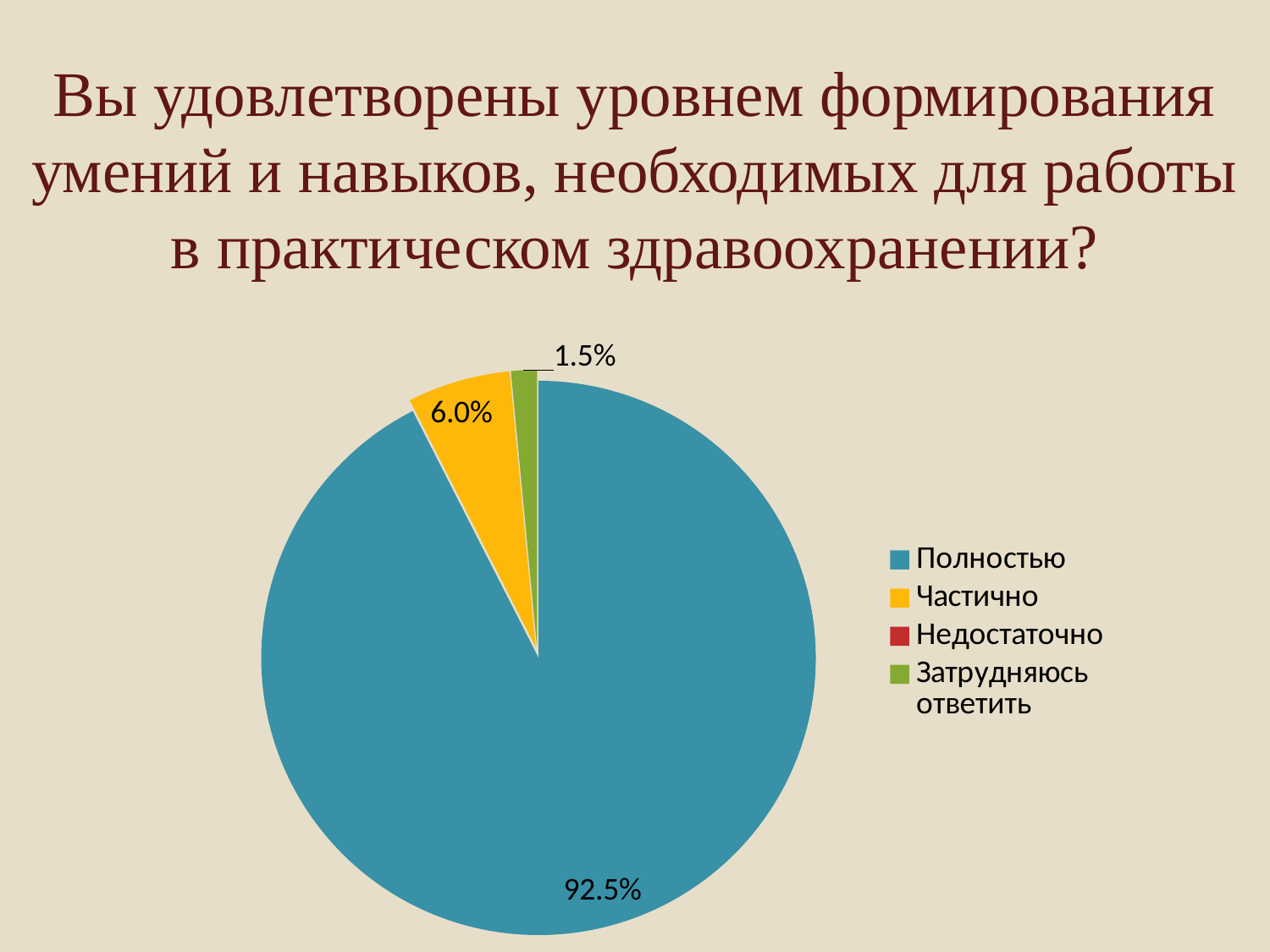
What percentage of respondents answered "Частично"? 6.0% Which answer category has the largest share of the pie? Полностью Which of the labelled slices is the smallest? Затрудняюсь ответить What percentage of respondents answered "Полностью"? 92.5% What type of chart is shown on the slide? pie chart What percentage of respondents answered "Затрудняюсь ответить"? 1.5% What is the difference in percentage points between "Полностью" and "Частично"? 86.5 How many categories are listed in the legend? 4 Which legend entry is shown in red? Недостаточно What colour is the slice for "Частично"? yellow What is the difference in percentage points between "Частично" and "Затрудняюсь ответить"? 4.5 Which is larger: the share for "Частично" or the share for "Затрудняюсь ответить"? Частично